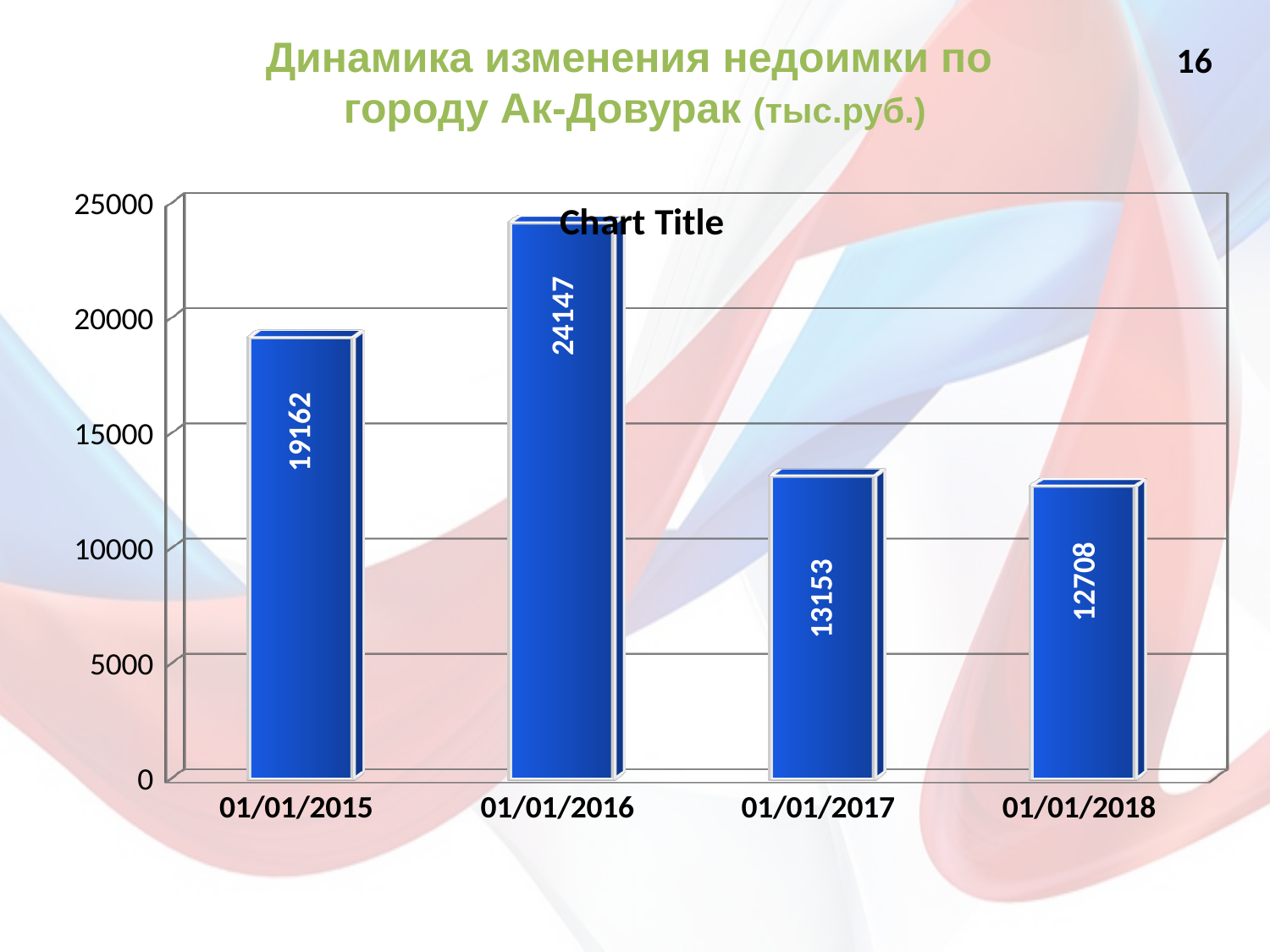
What is the difference between the values for 01/01/2017 and 01/01/2018? 445 What is the value for 01/01/2017? 13153 What kind of chart is shown on the slide? bar chart Which is larger, the value for 01/01/2015 or the value for 01/01/2017? 01/01/2015 Which date has the lowest value? 01/01/2018 Which date has the highest value? 01/01/2016 What is the difference between the values for 01/01/2016 and 01/01/2015? 4985 What is the value for 01/01/2018? 12708 What is the value for 01/01/2016? 24147 Is the value for 01/01/2016 greater or less than 20000? greater How many dates are shown on the x axis? 4 What is the value for 01/01/2015? 19162